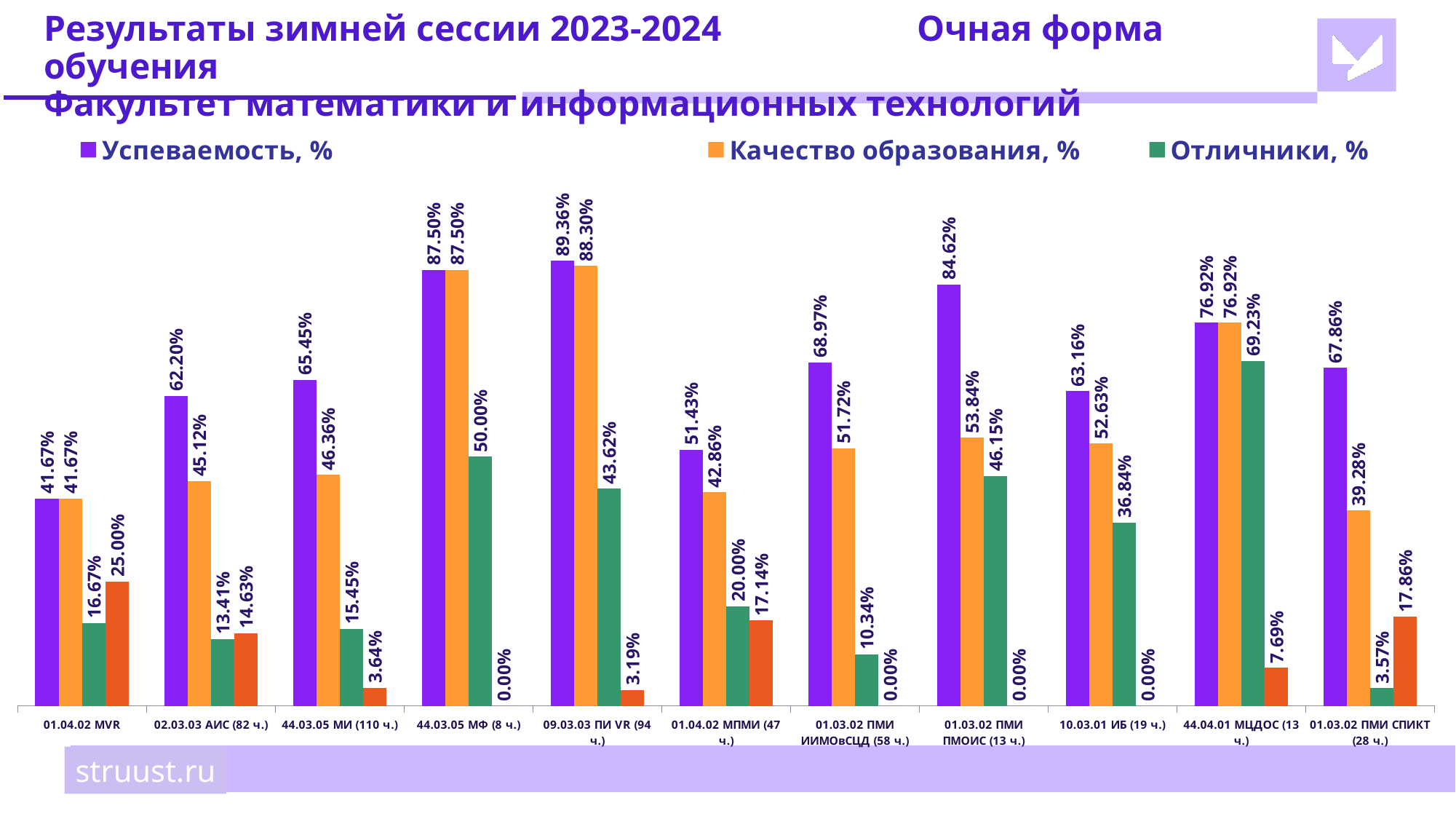
Which category has the highest Отличники, % value? 44.04.01 МЦДОС (13 ч.) Which category has the lowest Успеваемость, % value? 01.04.02 MVR What type of chart is shown on the slide? bar chart Which is larger for 01.03.02 ПМИ ПМОИС (13 ч.): Качество образования, % or Отличники, %? Качество образования, % What is the Отличники, % value for 10.03.01 ИБ (19 ч.)? 36.84% How many categories are shown on the x axis of the chart? 11 What is the Качество образования, % value for 01.03.02 ПМИ СПИКТ (28 ч.)? 39.28% What is the Успеваемость, % value for 09.03.03 ПИ VR (94 ч.)? 89.36% Is the Успеваемость, % value for 44.03.05 МФ (8 ч.) higher or lower than that for 44.04.01 МЦДОС (13 ч.)? higher Which category has the highest Успеваемость, % value? 09.03.03 ПИ VR (94 ч.) How many series does the chart legend list? 3 What is the difference between Успеваемость, % and Качество образования, % for 02.03.03 АИС (82 ч.)? 17.08%